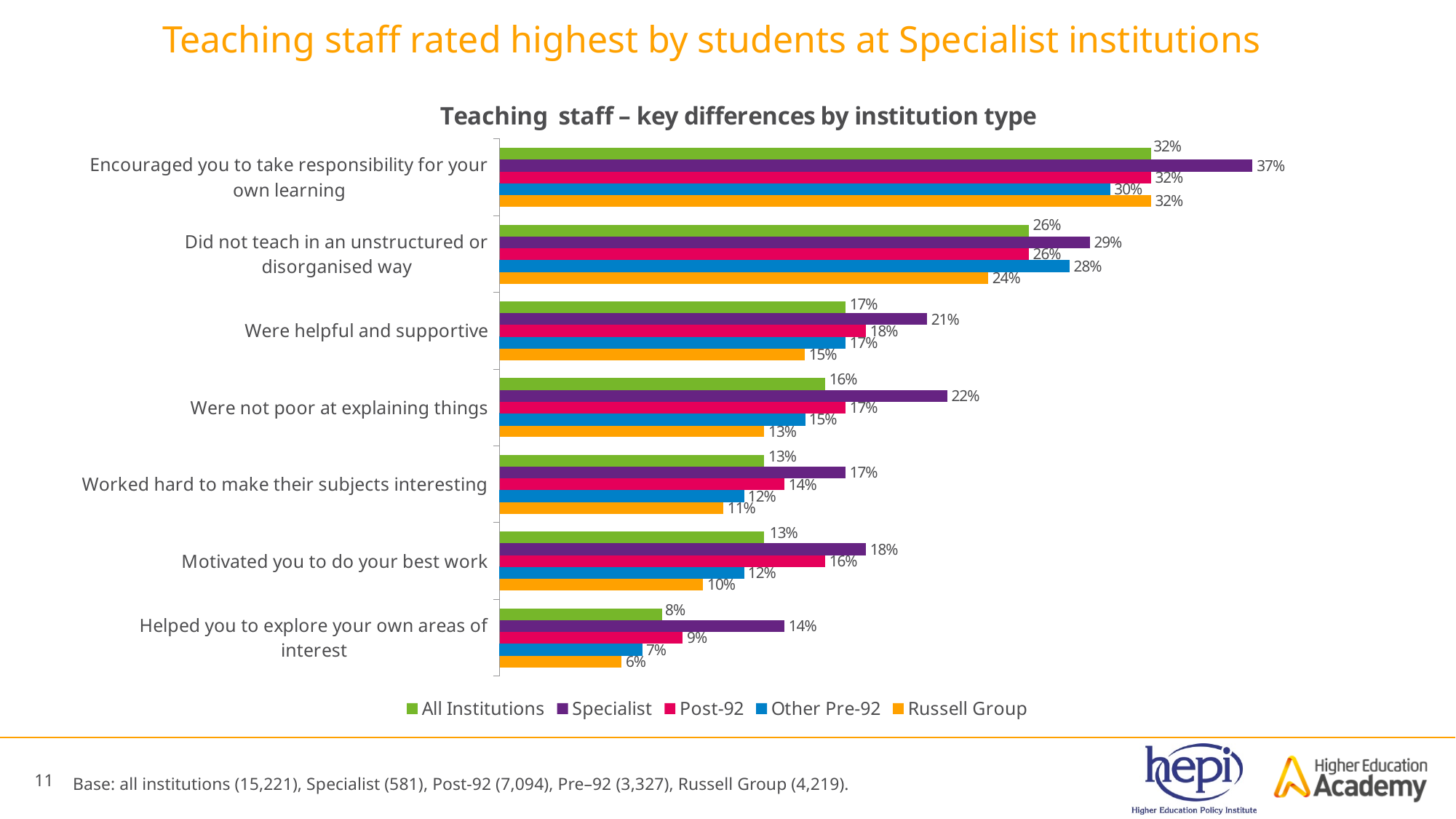
Which institution type has the highest value for 'Were not poor at explaining things'? Specialist What is the title of the chart? Teaching staff – key differences by institution type Which is larger for 'Were helpful and supportive': the Post-92 value or the Russell Group value? Post-92 What kind of chart is shown on the slide? Bar chart Which colour represents the Russell Group series in the chart? Orange What is the difference between the Specialist and Russell Group values for 'Helped you to explore your own areas of interest'? 8% What is the value for Other Pre-92 for 'Helped you to explore your own areas of interest'? 7% How many series does the legend list? 5 Which institution type has the lowest value for 'Motivated you to do your best work'? Russell Group What is the value for Specialist institutions for 'Encouraged you to take responsibility for your own learning'? 37% How many categories (statements) are shown on the chart? 7 What is the value for Russell Group for 'Did not teach in an unstructured or disorganised way'? 24%